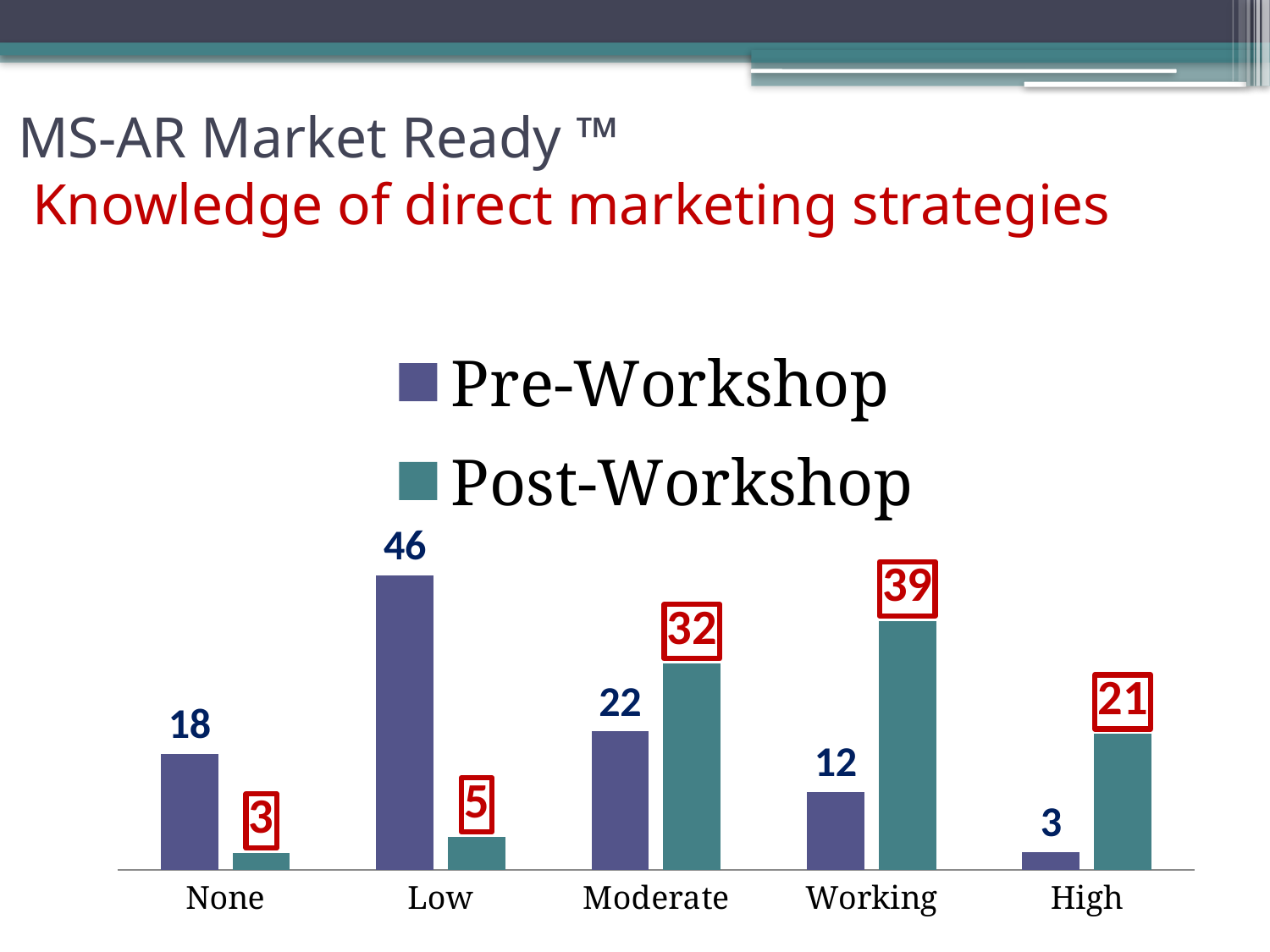
How many series does the legend list? 2 What is the Post-Workshop value for the None category? 3 Which category has the lowest Post-Workshop value? None What kind of chart is shown on the slide? Bar chart What is the Pre-Workshop value for the Low category? 46 How many categories are shown on the x axis? 5 Which category has the highest Pre-Workshop value? Low What is the difference between the Pre-Workshop values for Low and None? 28 What is the Post-Workshop value for the Working category? 39 Which is larger for the Moderate category, the Pre-Workshop value or the Post-Workshop value? Post-Workshop What is the difference between the Post-Workshop and Pre-Workshop values for the High category? 18 What are the two series named in the legend? Pre-Workshop and Post-Workshop